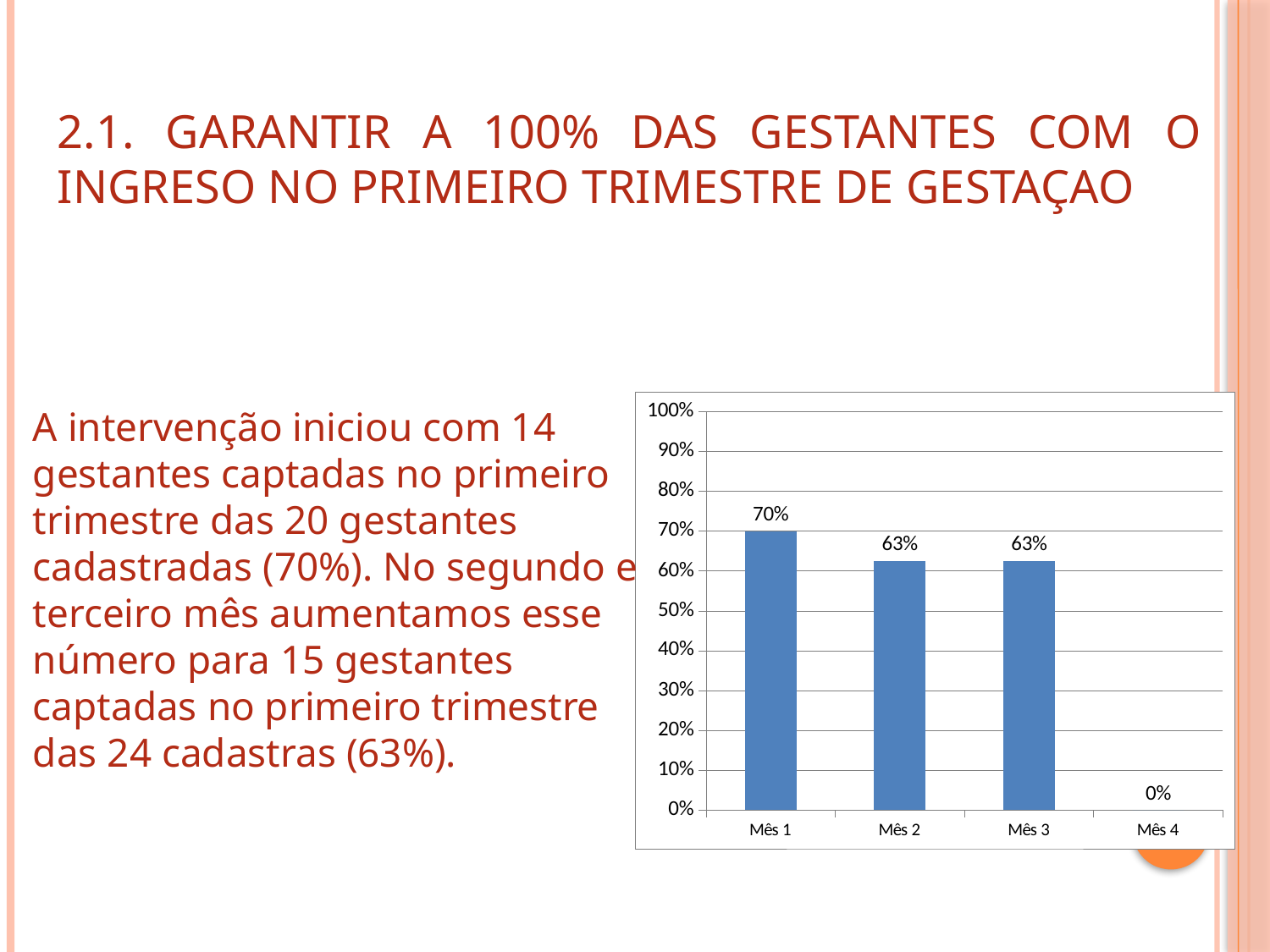
Is the value for Mês 3 greater or less than 50%? greater How many months are shown on the x axis? 4 What is the value for Mês 1? 70% Which is larger, the value for Mês 1 or the value for Mês 3? Mês 1 What is the highest value shown on the y axis? 100% What is the value for Mês 2? 63% Which month has the lowest value? Mês 4 Which month has the highest value? Mês 1 What kind of chart is shown on the slide? bar chart What is the value for Mês 4? 0% What is the difference between the values for Mês 1 and Mês 2? 7% Do the values rise or fall from Mês 1 to Mês 4? fall